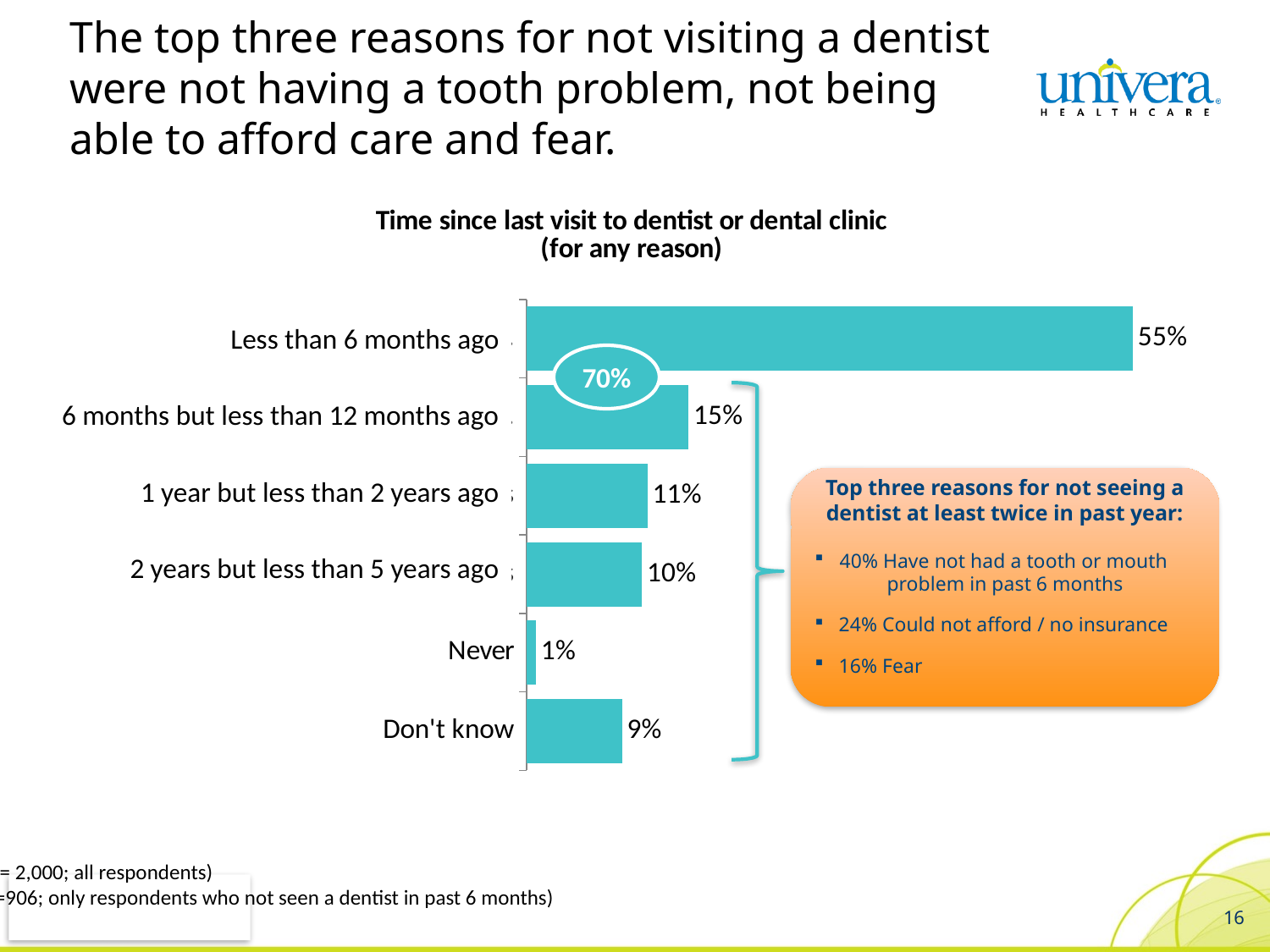
What is the value for "Less than 6 months ago"? 55% Which category has the lowest value? Never How many categories are shown in the chart? 6 What is the value for "Don't know"? 9% What kind of chart is shown on the slide? Bar chart What is the value for "Never"? 1% What is the title of the chart? Time since last visit to dentist or dental clinic (for any reason) What is the difference between "Less than 6 months ago" and "6 months but less than 12 months ago"? 40% What is the value for "6 months but less than 12 months ago"? 15% What is the difference between "1 year but less than 2 years ago" and "Don't know"? 2% Which is larger: "2 years but less than 5 years ago" or "Don't know"? 2 years but less than 5 years ago Which category has the highest value? Less than 6 months ago